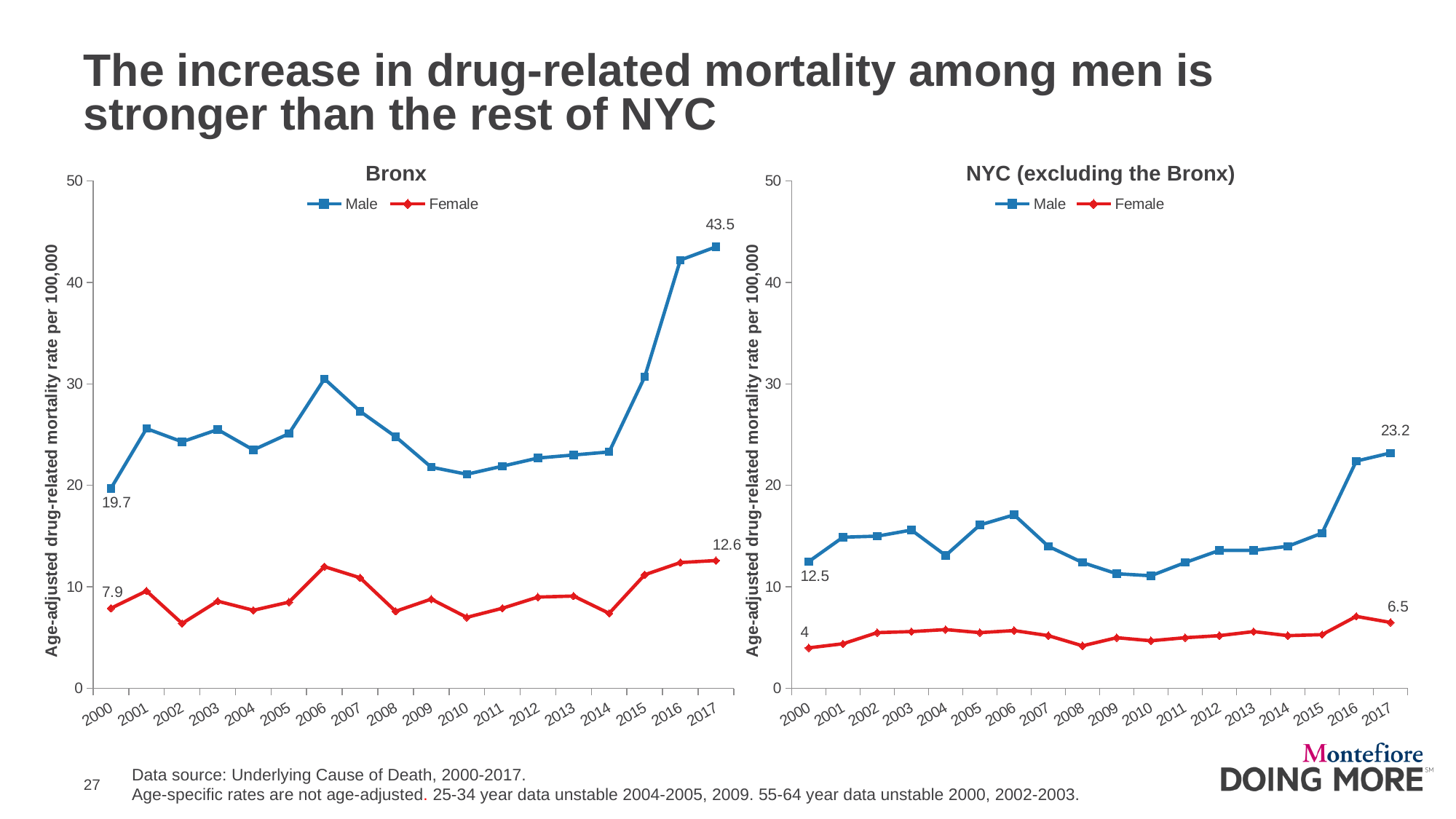
How many years are plotted on the x axis of the Bronx chart? 18 Which is larger in 2017: the Bronx male rate or the NYC (excluding the Bronx) male rate? Bronx male rate In the Bronx chart, by how much did the male rate increase from 2000 to 2017? 23.8 In the NYC (excluding the Bronx) chart, what is the difference between the male and female rates in 2017? 16.7 In the NYC (excluding the Bronx) chart, what is the male rate in 2000? 12.5 In the NYC (excluding the Bronx) chart, is the male rate in 2010 greater or less than 20? less In the NYC (excluding the Bronx) chart, what is the female rate in 2017? 6.5 What type of chart is the Bronx chart? Line chart In the Bronx chart, what is the female drug-related mortality rate in 2000? 7.9 In the Bronx chart, what is the male drug-related mortality rate in 2017? 43.5 In the Bronx chart, is the male rate in 2016 greater or less than 40? greater How many series does the legend of the NYC (excluding the Bronx) chart list? 2